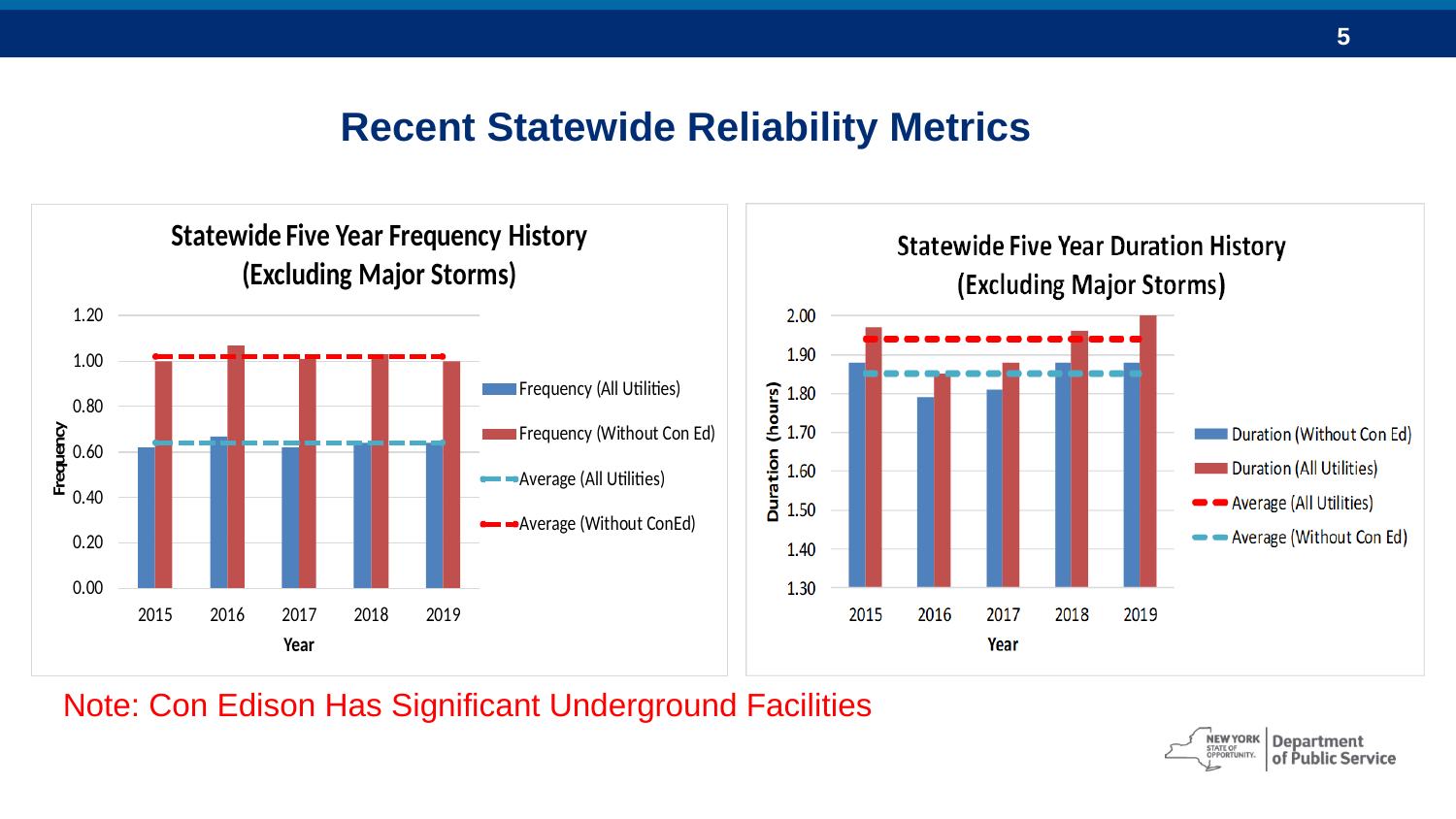
In the Statewide Five Year Frequency History chart, is the Frequency (Without Con Ed) value for 2016 greater or less than 1.00? greater In the Statewide Five Year Duration History chart, which year has the highest Duration (All Utilities) bar? 2019 What is the y-axis title of the Statewide Five Year Duration History chart? Duration (hours) In the Statewide Five Year Frequency History chart, which is larger for 2016: Frequency (All Utilities) or Frequency (Without Con Ed)? Frequency (Without Con Ed) What kind of chart is the Statewide Five Year Frequency History chart? bar chart How many years are shown on the x axis of the Statewide Five Year Frequency History chart? 5 In the Statewide Five Year Duration History chart, which year has the lowest Duration (Without Con Ed) bar? 2016 In the Statewide Five Year Frequency History chart, which year has the highest Frequency (Without Con Ed) bar? 2016 In the Statewide Five Year Duration History chart, does the Duration (All Utilities) value rise or fall from 2016 to 2019? rise In the Statewide Five Year Frequency History chart, is the Frequency (All Utilities) value for 2015 greater or less than 0.80? less In the Statewide Five Year Duration History chart, is the Duration (Without Con Ed) value for 2016 greater or less than 1.90? less How many entries does the legend of the Statewide Five Year Duration History chart list? 4